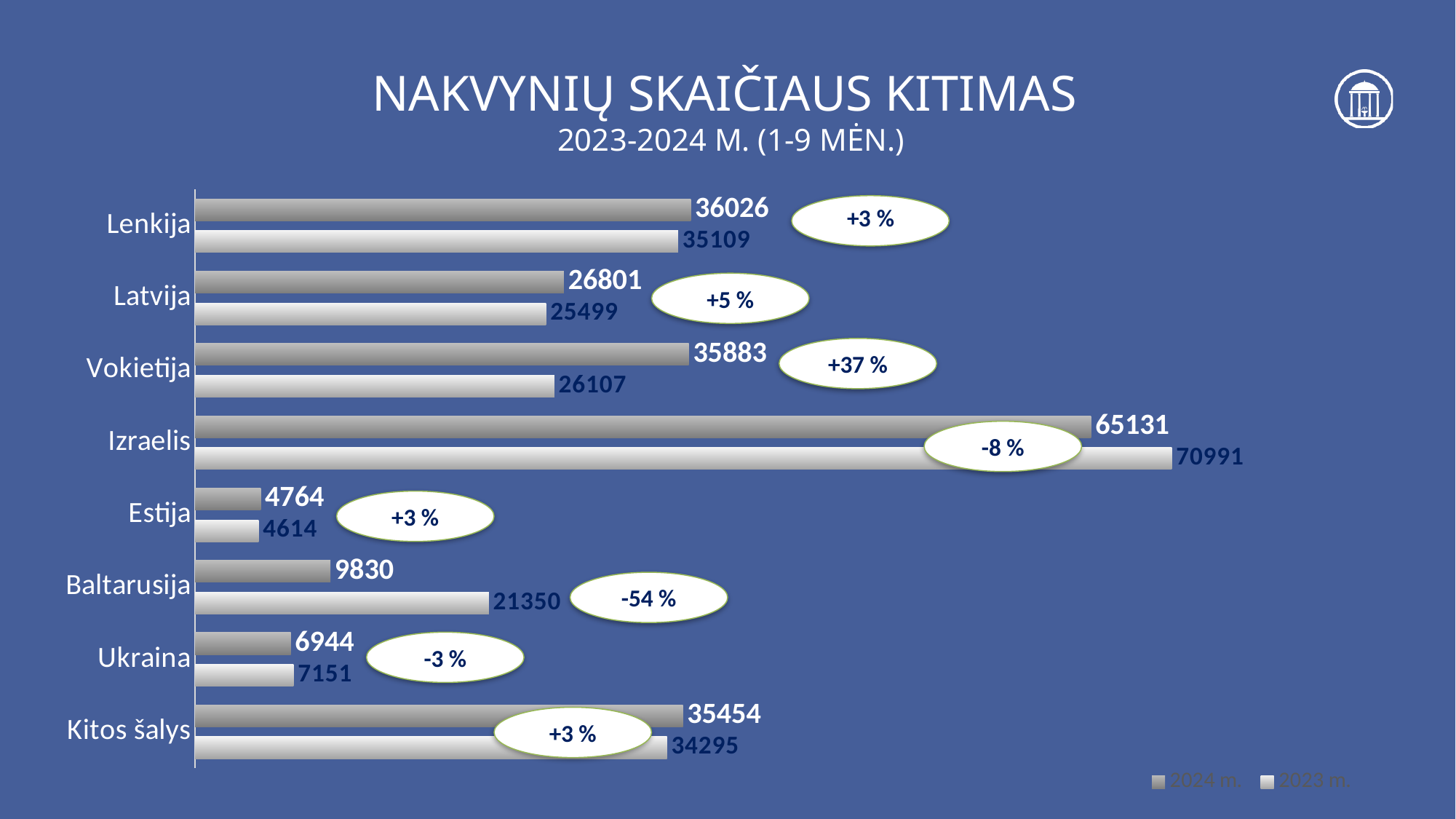
How many series does the legend list? 2 What is the title of the chart? NAKVYNIŲ SKAIČIAUS KITIMAS 2023-2024 M. (1-9 MĖN.) Which category has the highest 2024 m. value? Izraelis What is the difference between the 2024 m. and 2023 m. values for Lenkija? 917 Which category has the lowest 2023 m. value? Estija What kind of chart is shown on the slide? Bar chart What percentage change is shown in the oval next to Baltarusija? -54 % What is the 2023 m. value for Baltarusija? 21350 How many categories are shown on the chart? 8 What is the 2024 m. value for Estija? 4764 Which is larger for Ukraina, the 2024 m. value or the 2023 m. value? 2023 m. What is the 2024 m. value for Vokietija? 35883